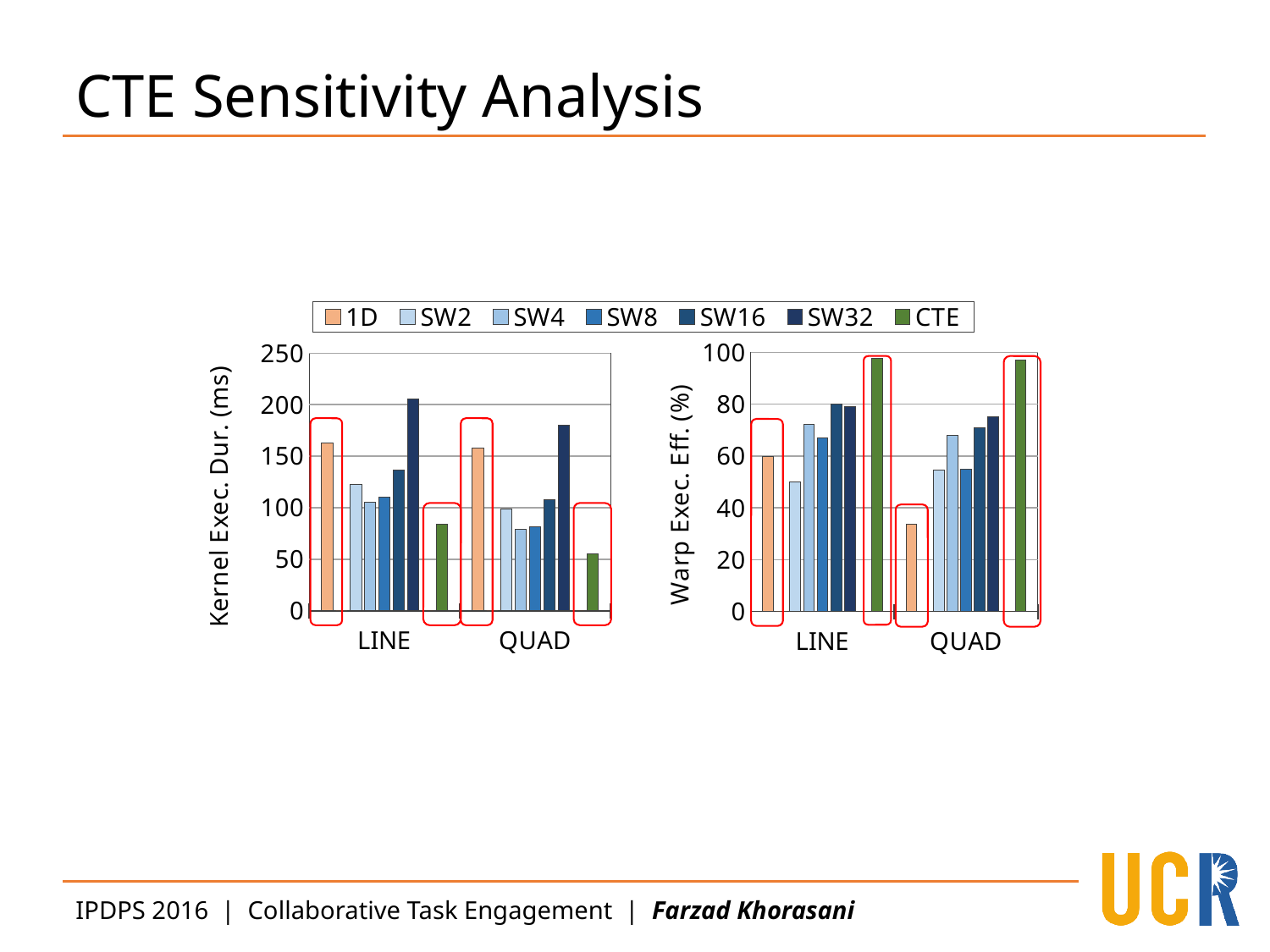
In the left chart (Kernel Exec. Dur.), which series has the lowest value for QUAD? CTE What is the y-axis label of the left chart? Kernel Exec. Dur. (ms) In the right chart (Warp Exec. Eff.), which series has the lowest value for QUAD? 1D What kind of chart is the left chart (Kernel Exec. Dur.)? bar chart In the right chart (Warp Exec. Eff.), which series has the highest value for LINE? CTE How many series does the legend list? 7 In the left chart (Kernel Exec. Dur.), is the value for CTE in QUAD greater or less than 100? less How many categories are shown on the x axis of the right chart (Warp Exec. Eff.)? 2 In the left chart (Kernel Exec. Dur.), which series has the highest value for LINE? SW32 In the left chart (Kernel Exec. Dur.), is the value for 1D in LINE greater or less than 150? greater In the right chart (Warp Exec. Eff.), which is larger for LINE: SW2 or SW4? SW4 In the right chart (Warp Exec. Eff.), is the value for CTE in LINE greater or less than 80? greater